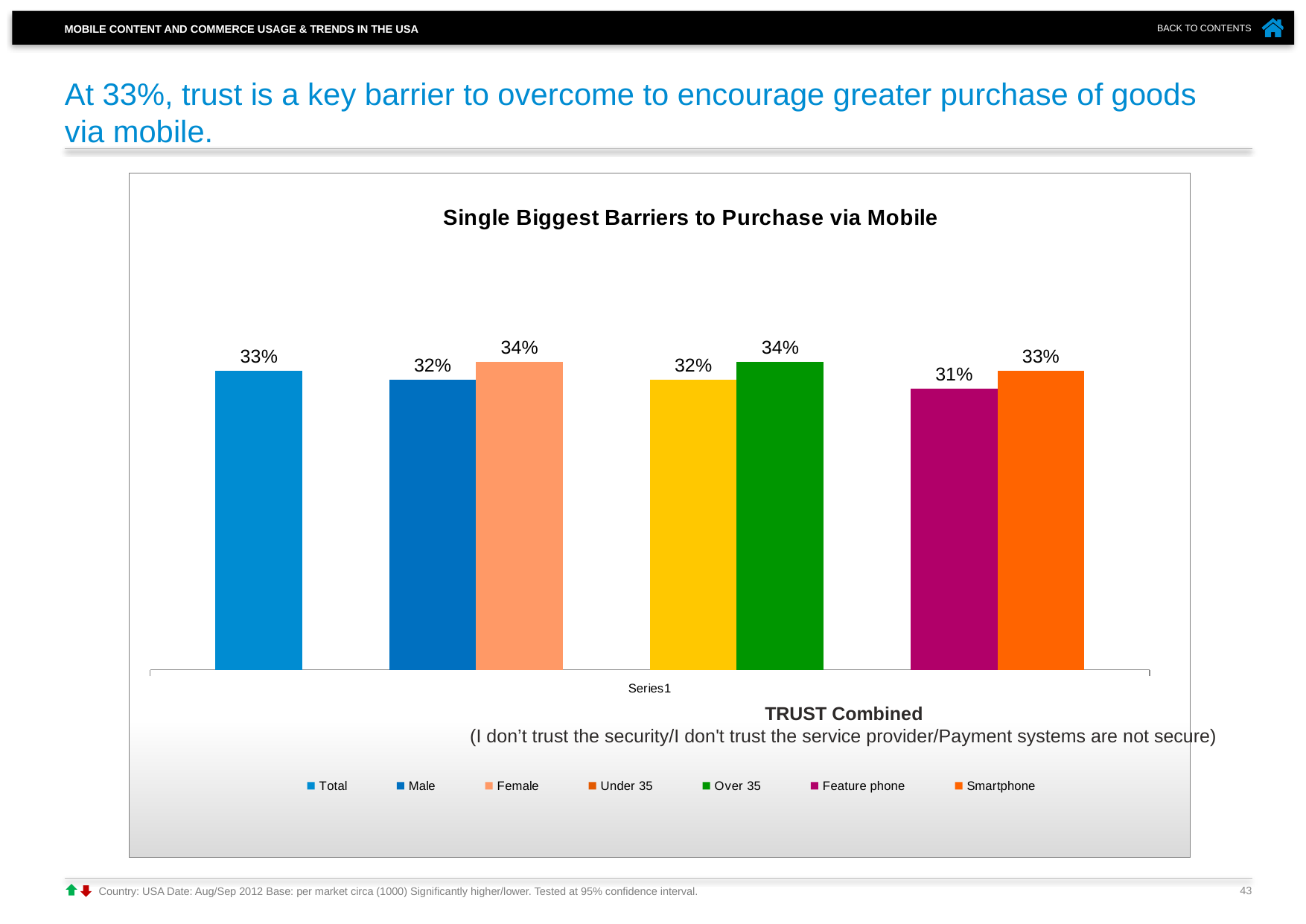
Which series has the lowest value in the chart? Feature phone What is the difference between the Female and Male values? 2% What is the value for Feature phone in the chart? 31% What is the value for Smartphone in the chart? 33% What is the title of the chart? Single Biggest Barriers to Purchase via Mobile What kind of chart is shown on the slide? Bar chart Which is larger, the value for Over 35 or the value for Under 35? Over 35 What is the value for Under 35 in the chart? 32% What is the difference between the Smartphone and Feature phone values? 2% How many series does the legend list? 7 What is the value for Total in the Single Biggest Barriers to Purchase via Mobile chart? 33% What is the value for Female in the chart? 34%